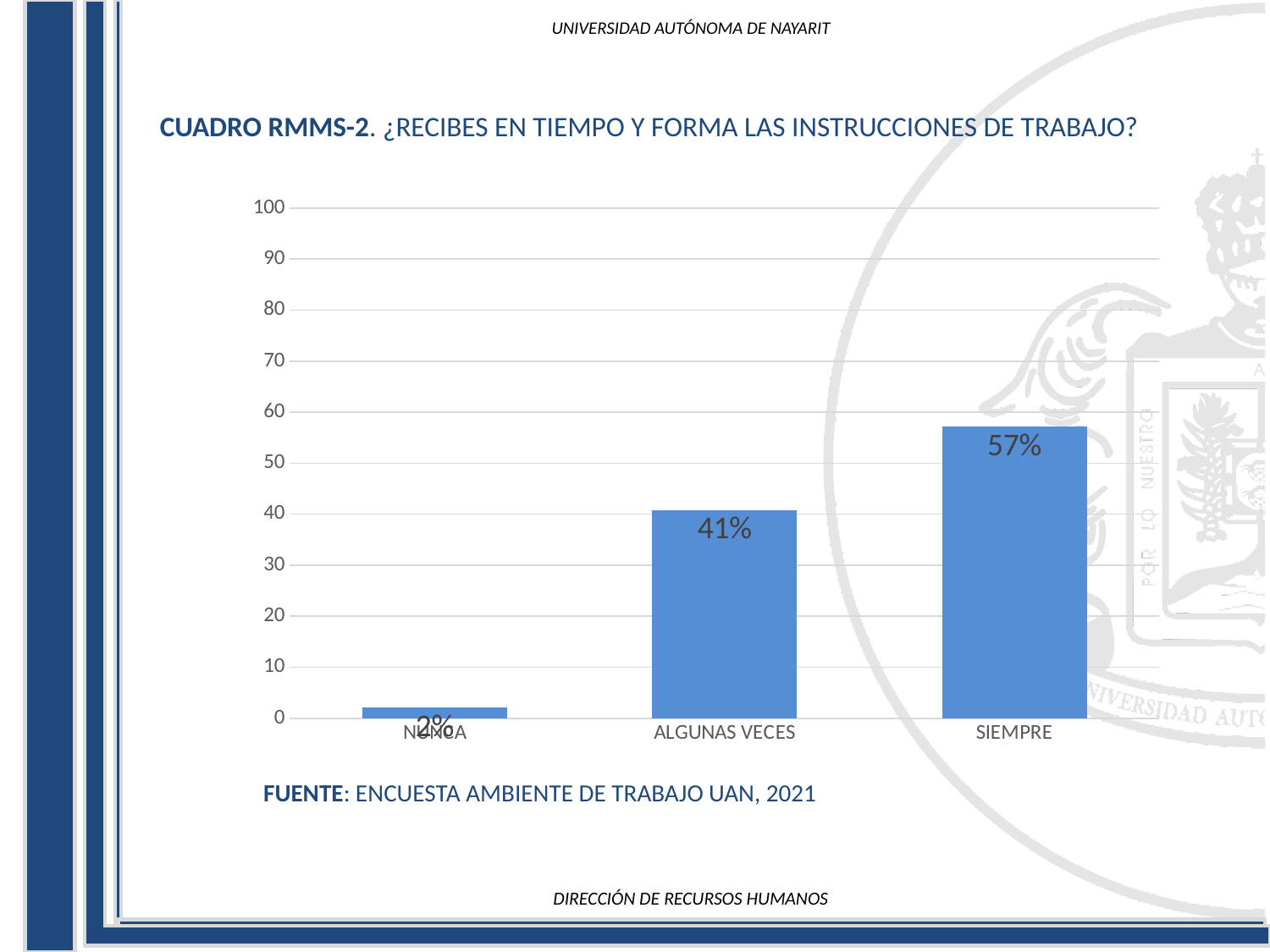
How many categories are shown on the x axis? 3 Is the value for SIEMPRE greater or less than 50? greater Which is larger, the value for ALGUNAS VECES or the value for SIEMPRE? SIEMPRE What is the value for NUNCA? 2% What is the difference between the values for ALGUNAS VECES and NUNCA? 39% What kind of chart is shown on the slide? bar chart What is the value for SIEMPRE? 57% What is the value for ALGUNAS VECES? 41% Which category has the lowest value? NUNCA What is the difference between the values for SIEMPRE and ALGUNAS VECES? 16% Which category has the highest value? SIEMPRE What is the source cited below the chart? ENCUESTA AMBIENTE DE TRABAJO UAN, 2021